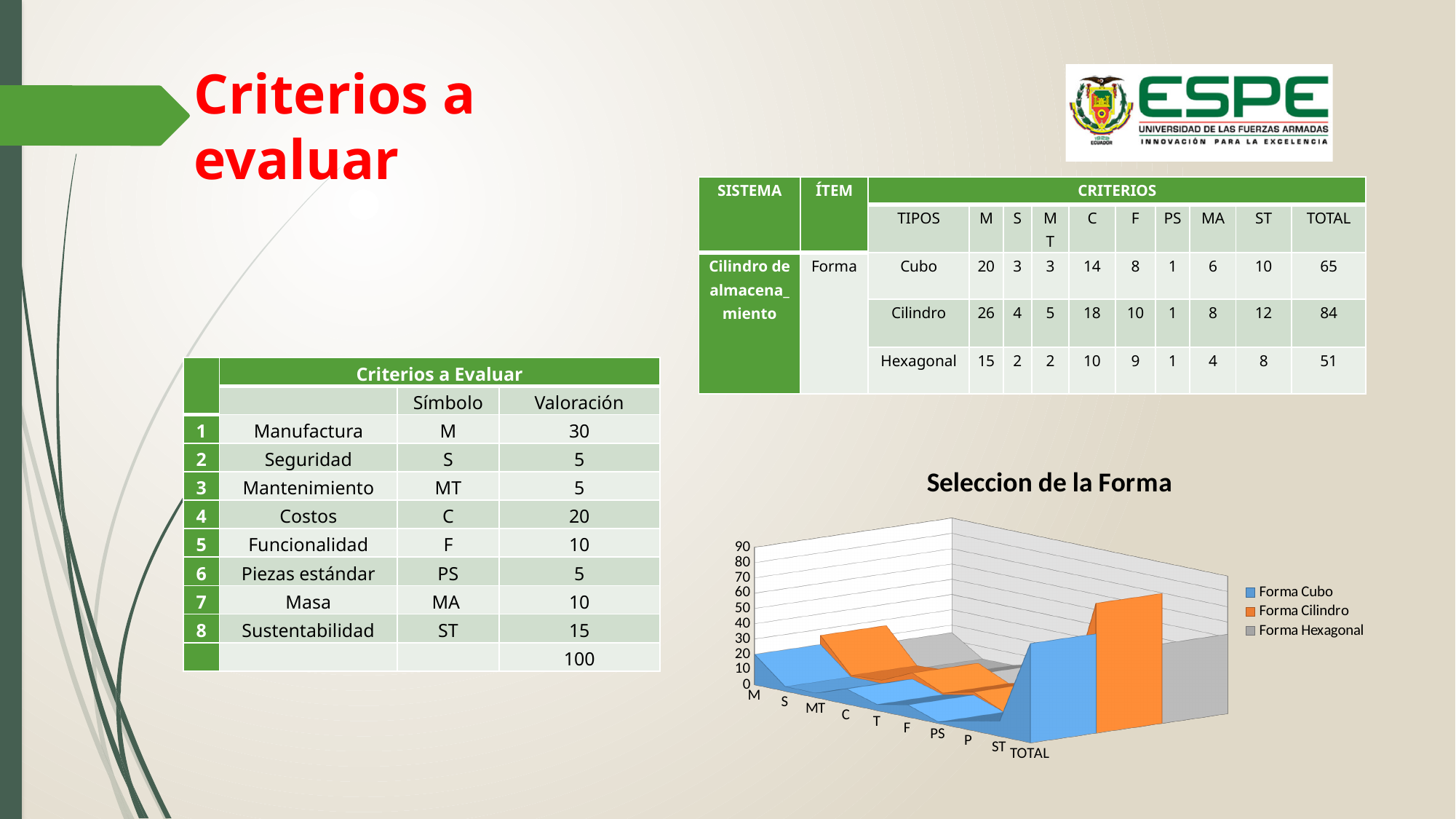
In the "Seleccion de la Forma" chart, is the value for Forma Cubo at category S greater or less than 20? less In the "Seleccion de la Forma" chart, which category has the highest value for the Forma Cilindro series? TOTAL How many series does the legend of the "Seleccion de la Forma" chart list? 3 In the "Seleccion de la Forma" chart, is the TOTAL value for Forma Cilindro greater or less than 60? greater In the "Seleccion de la Forma" chart, at the TOTAL category, which is larger: Forma Cilindro or Forma Cubo? Forma Cilindro In the "Seleccion de la Forma" chart, is the value for Forma Cilindro at category M greater or less than 50? less What kind of chart is shown under the title "Seleccion de la Forma"? area chart What is the highest tick value shown on the vertical axis of the "Seleccion de la Forma" chart? 90 Which series in the "Seleccion de la Forma" chart is shown in orange? Forma Cilindro What is the title of the chart on the slide? Seleccion de la Forma In the "Seleccion de la Forma" chart, which series reaches the highest value at the TOTAL category? Forma Cilindro